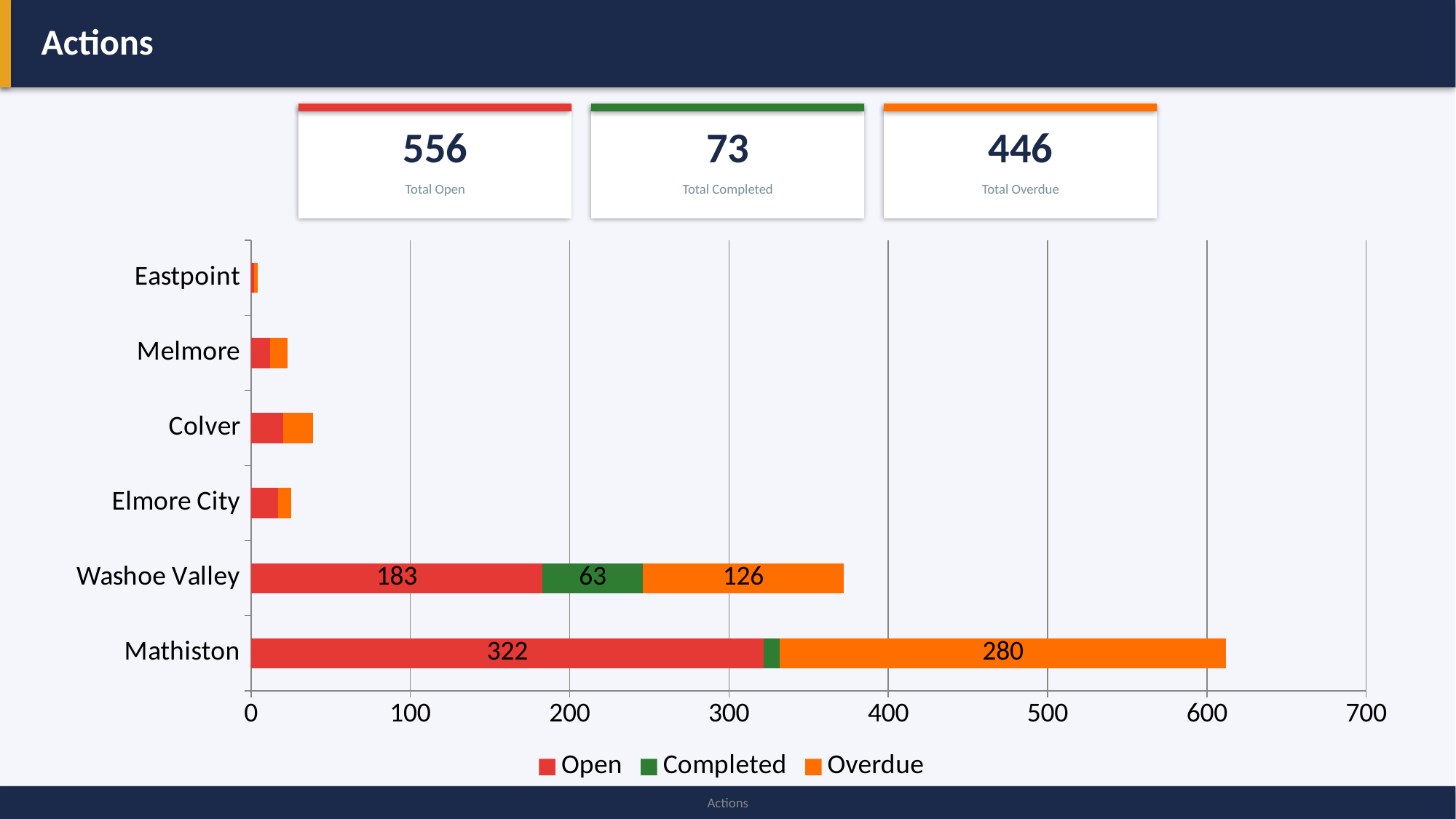
What is the total of the stacked bar for Washoe Valley? 372 What is the Overdue value for Mathiston? 280 What is the Completed value for Washoe Valley? 63 Which category has the shortest stacked bar? Eastpoint How many series does the legend list? 3 How much larger is the Open value for Mathiston than the Open value for Washoe Valley? 139 What is the Open value for Washoe Valley? 183 Is the total length of the Mathiston bar greater or less than 600? greater What is the difference between the Overdue values for Mathiston and Washoe Valley? 154 Which category has the longest stacked bar? Mathiston How many categories are shown on the chart? 6 What is the Open value for Mathiston? 322